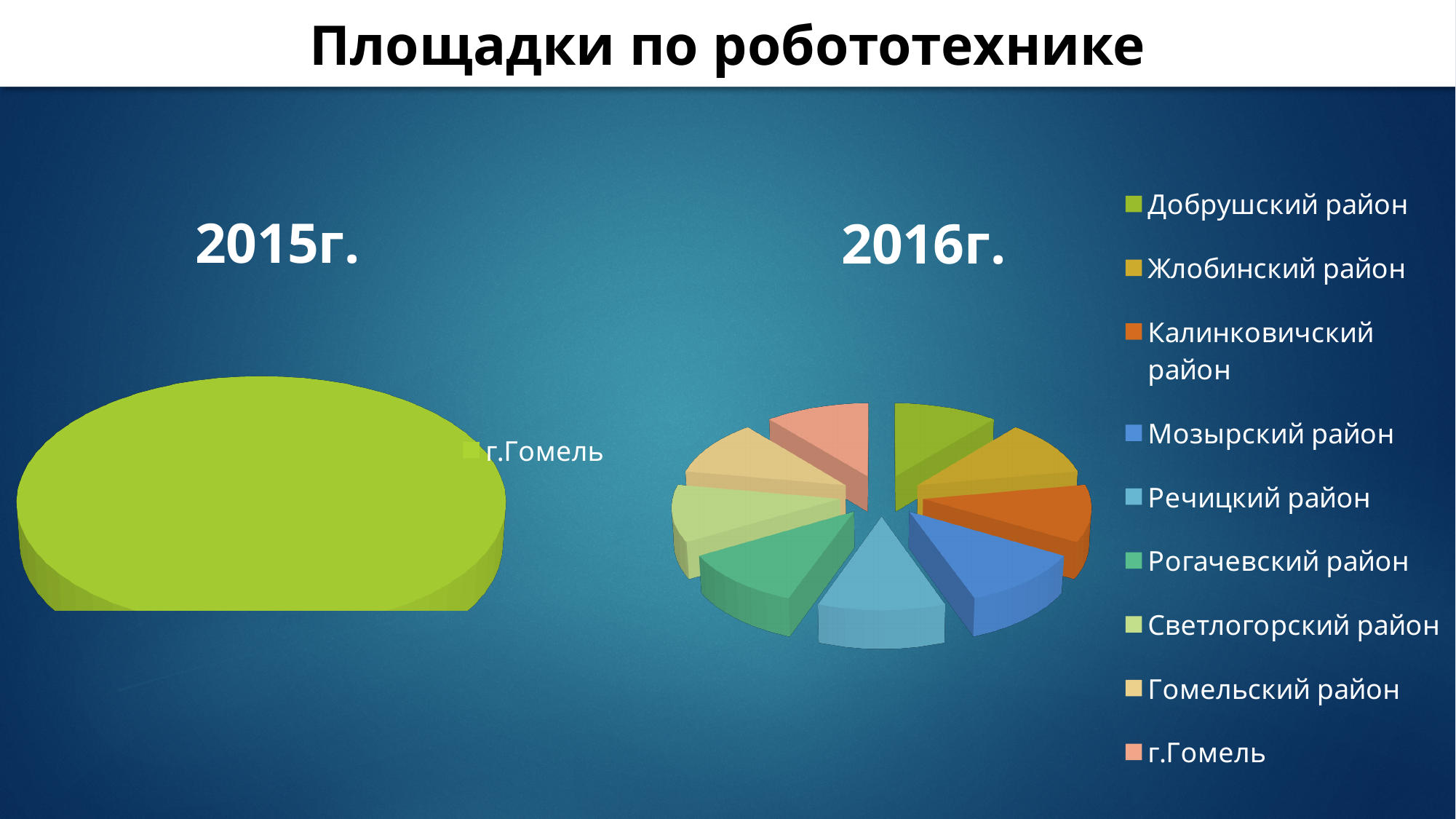
How many entries does the legend of the 2016г. chart list? 9 Which category is shown in the 2015г. chart on the left? г.Гомель How many slices does the 2016г. pie chart on the right have? 9 How many entries does the legend of the 2015г. chart list? 1 What kind of chart is the 2016г. chart on the right? pie chart What kind of chart is the 2015г. chart on the left? pie chart In the 2016г. chart, which legend entry is listed first? Добрушский район What is the title of the slide containing the two pie charts? Площадки по робототехнике How many categories does the 2015г. chart on the left show? 1